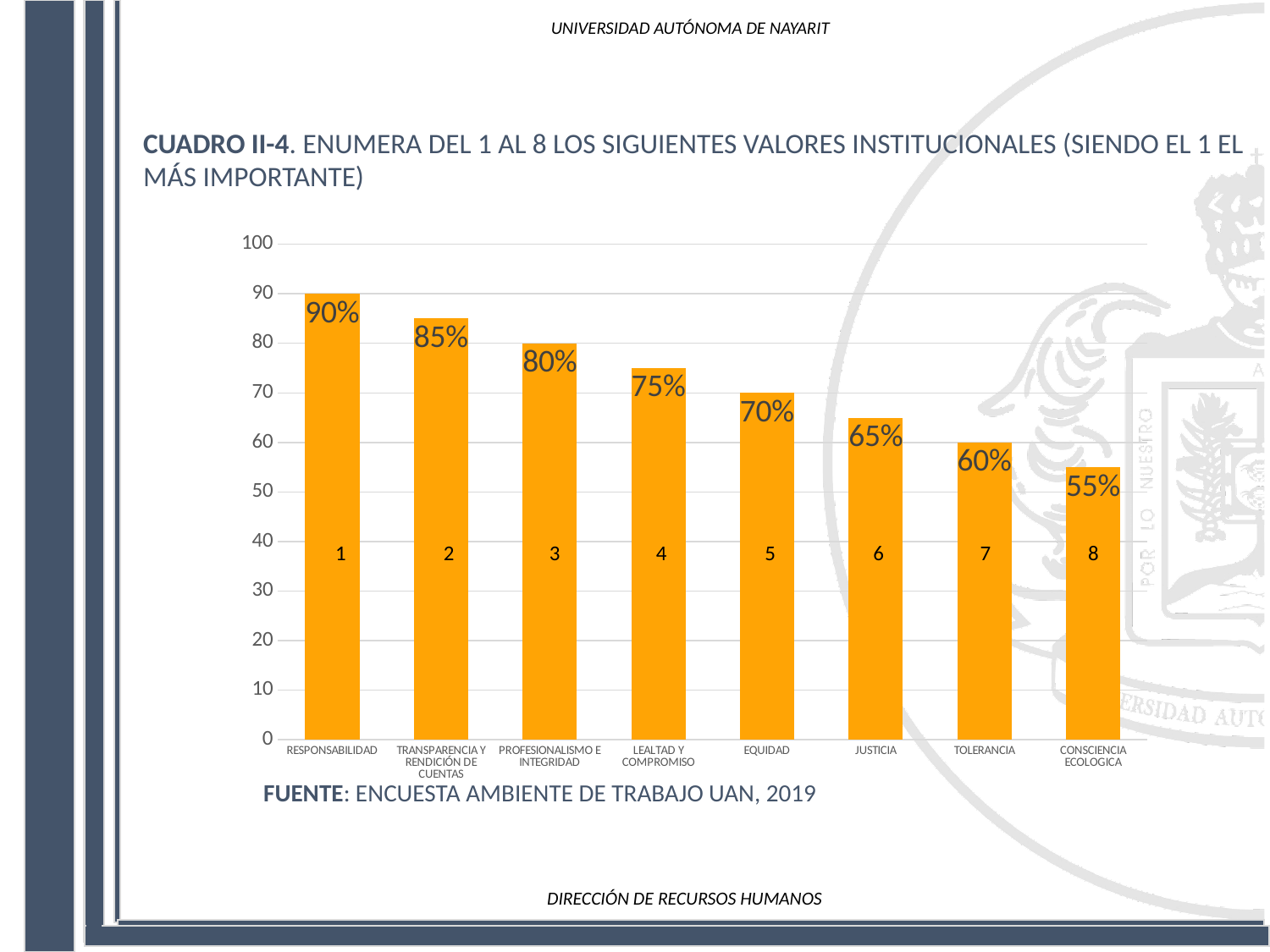
Do the values rise or fall from left to right along the x axis? fall What is the value for RESPONSABILIDAD? 90% How many categories are shown in the chart? 8 What source is cited below the chart? ENCUESTA AMBIENTE DE TRABAJO UAN, 2019 Which is larger, the value for JUSTICIA or the value for LEALTAD Y COMPROMISO? LEALTAD Y COMPROMISO Which category has the lowest value? CONSCIENCIA ECOLOGICA What kind of chart is shown on the slide? bar chart Which category has the highest value? RESPONSABILIDAD What is the value for EQUIDAD? 70% Is the value for PROFESIONALISMO E INTEGRIDAD greater or less than 70? greater What is the difference between the values for TRANSPARENCIA Y RENDICIÓN DE CUENTAS and TOLERANCIA? 25% What is the value for CONSCIENCIA ECOLOGICA? 55%